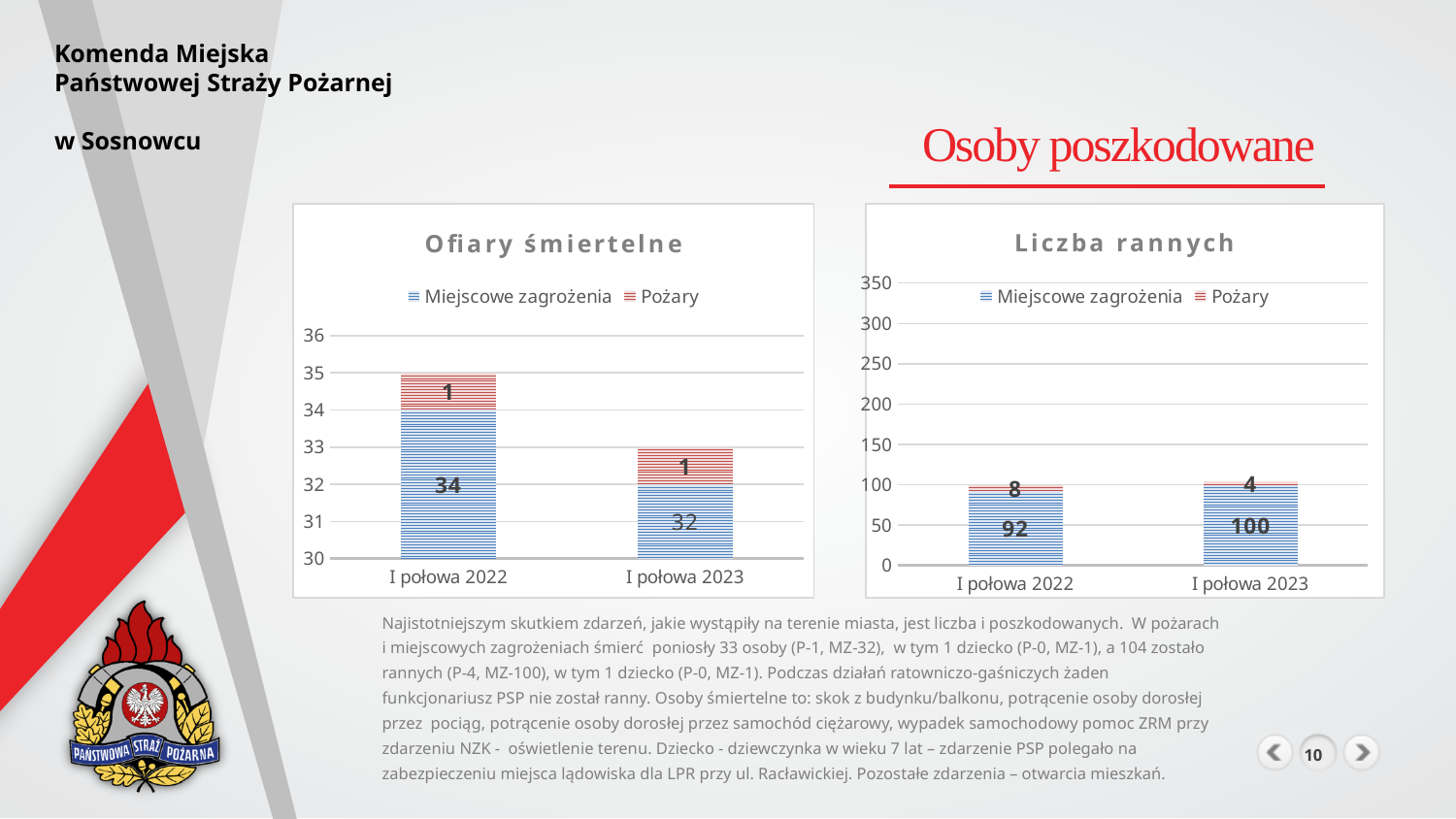
In the 'Ofiary śmiertelne' chart, what is the value for Pożary in I połowa 2023? 1 In the 'Liczba rannych' chart, what is the value for Miejscowe zagrożenia in I połowa 2023? 100 What type of chart is 'Ofiary śmiertelne'? Stacked bar chart In the 'Ofiary śmiertelne' chart, which period has the higher Miejscowe zagrożenia value, I połowa 2022 or I połowa 2023? I połowa 2022 How many series does the legend of the 'Liczba rannych' chart list? 2 In the 'Ofiary śmiertelne' chart, what is the value for Miejscowe zagrożenia in I połowa 2022? 34 In the 'Liczba rannych' chart, which period has the lower Pożary value? I połowa 2023 In the 'Liczba rannych' chart, what is the value for Pożary in I połowa 2022? 8 How many categories are shown on the x axis of the 'Liczba rannych' chart? 2 In the 'Ofiary śmiertelne' chart, what is the total of the stacked bar for I połowa 2023? 33 In the 'Liczba rannych' chart, what is the total of the stacked bar for I połowa 2023? 104 In the 'Liczba rannych' chart, what is the difference between the Miejscowe zagrożenia values for I połowa 2023 and I połowa 2022? 8